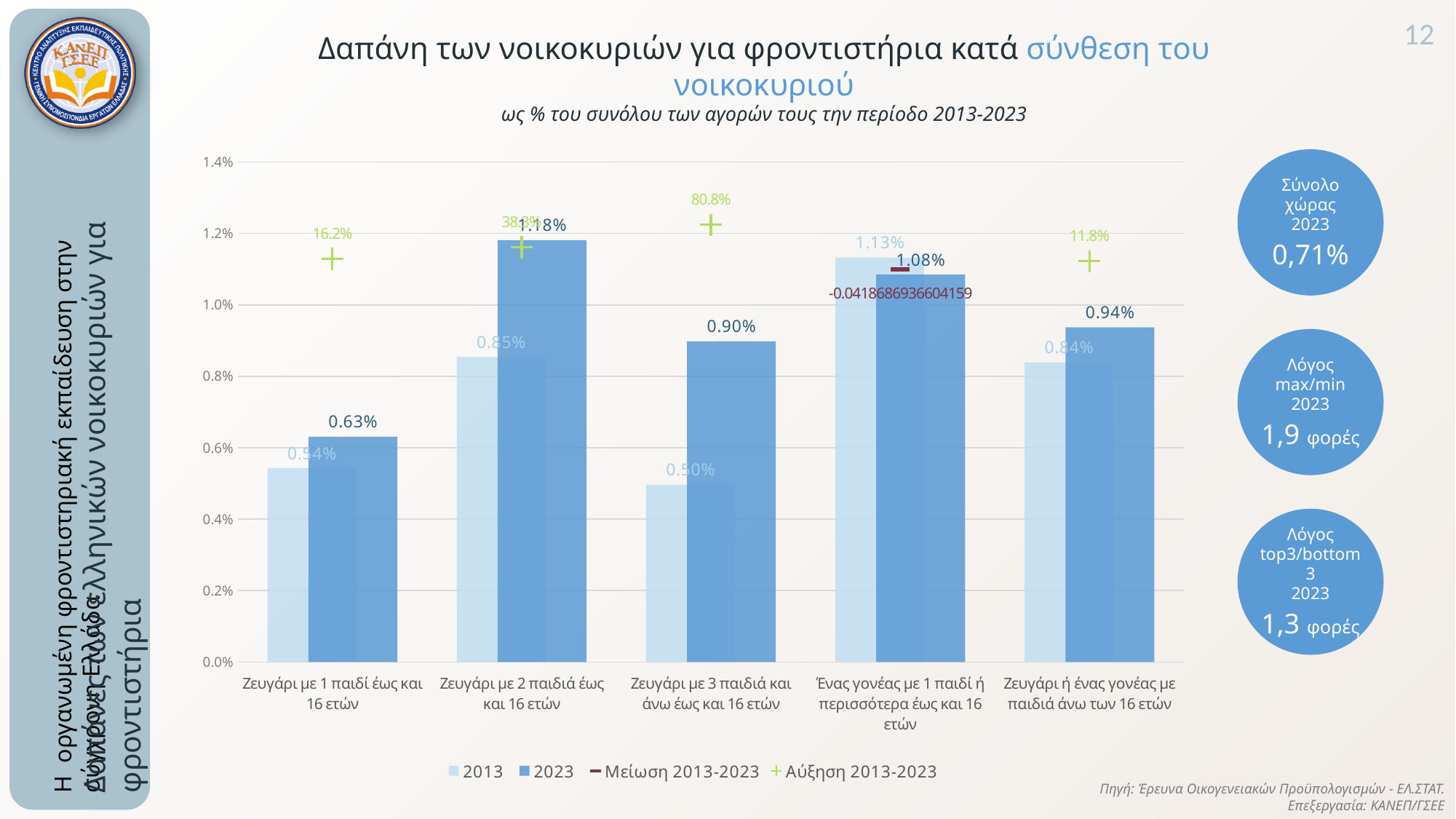
What percentage increase (Αύξηση 2013-2023) is shown for 'Ζευγάρι με 3 παιδιά και άνω έως και 16 ετών'? 80.8% How many entries does the legend list? 4 What was the value for 'Ζευγάρι με 3 παιδιά και άνω έως και 16 ετών' in 2013? 0.50% What value is shown in the 'Σύνολο χώρας 2023' circle on the right of the slide? 0,71% What was the value for 'Ζευγάρι με 1 παιδί έως και 16 ετών' in 2023? 0.63% Which category has the highest value in 2023? Ζευγάρι με 2 παιδιά έως και 16 ετών What is the difference between the 2023 and 2013 values for 'Ζευγάρι με 3 παιδιά και άνω έως και 16 ετών'? 0.40% For 'Ένας γονέας με 1 παιδί ή περισσότερα έως και 16 ετών', which year has the larger value, 2013 or 2023? 2013 What was the value for 'Ένας γονέας με 1 παιδί ή περισσότερα έως και 16 ετών' in 2013? 1.13% Which category has the lowest value in 2013? Ζευγάρι με 3 παιδιά και άνω έως και 16 ετών What type of chart is shown on the slide? Bar chart How many household composition categories are shown on the x axis? 5